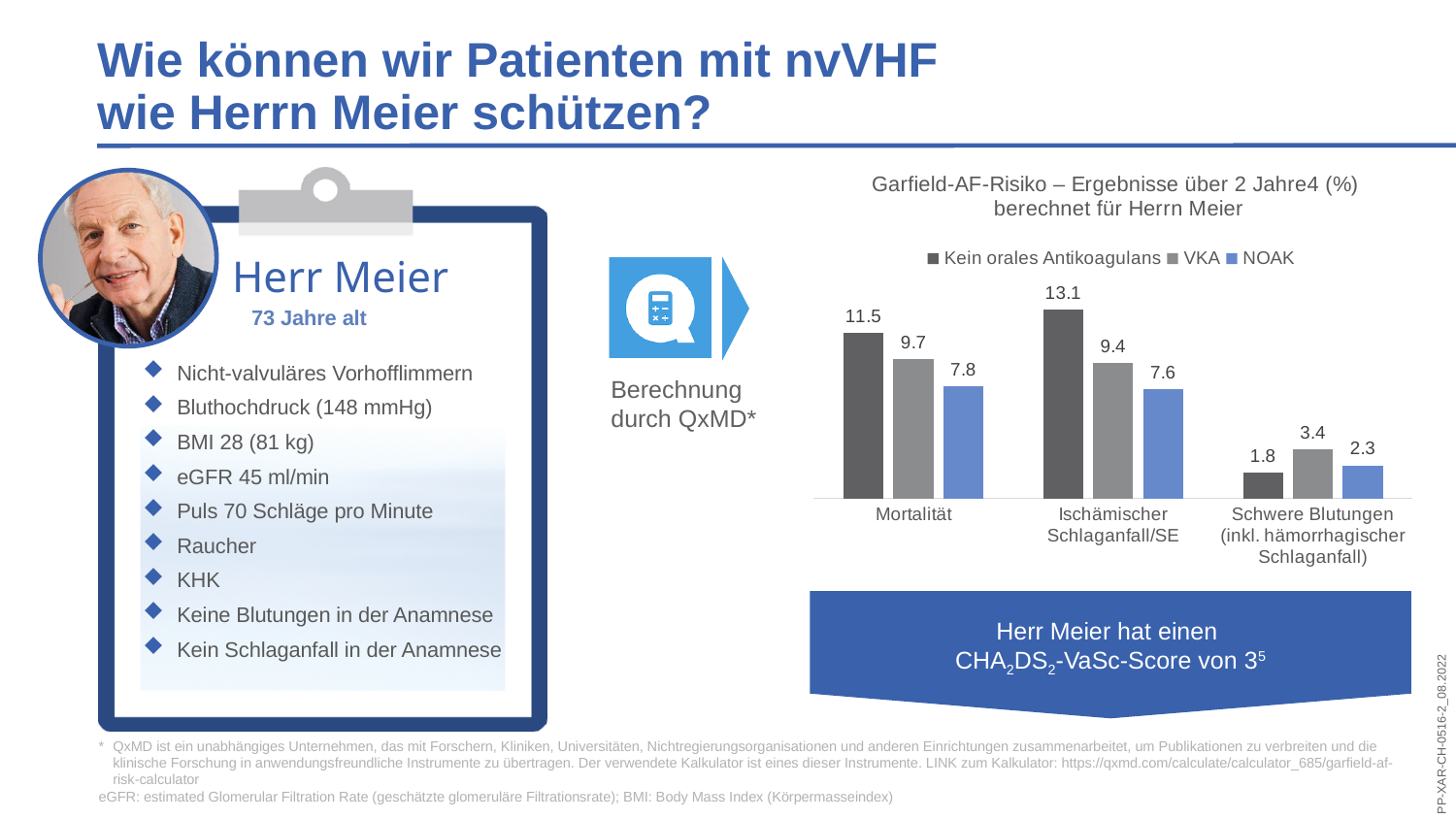
What type of chart is shown on the slide? bar chart Which is larger: the 'VKA' value for 'Mortalität' or the 'VKA' value for 'Ischämischer Schlaganfall/SE'? Mortalität What is the difference between the 'VKA' and 'NOAK' values in the 'Schwere Blutungen (inkl. hämorrhagischer Schlaganfall)' category? 1.1 How many series does the chart legend list? 3 Which series has the lowest value in the 'Schwere Blutungen (inkl. hämorrhagischer Schlaganfall)' category? Kein orales Antikoagulans What is the value for 'Kein orales Antikoagulans' in the 'Mortalität' category? 11.5 How many categories are shown on the x axis of the chart? 3 What is the value for 'VKA' in the 'Schwere Blutungen (inkl. hämorrhagischer Schlaganfall)' category? 3.4 What is the value for 'NOAK' in the 'Ischämischer Schlaganfall/SE' category? 7.6 What is the difference between the 'Kein orales Antikoagulans' and 'NOAK' values in the 'Mortalität' category? 3.7 Which series has the highest value in the 'Ischämischer Schlaganfall/SE' category? Kein orales Antikoagulans What is the title of the chart? Garfield-AF-Risiko – Ergebnisse über 2 Jahre4 (%) berechnet für Herrn Meier